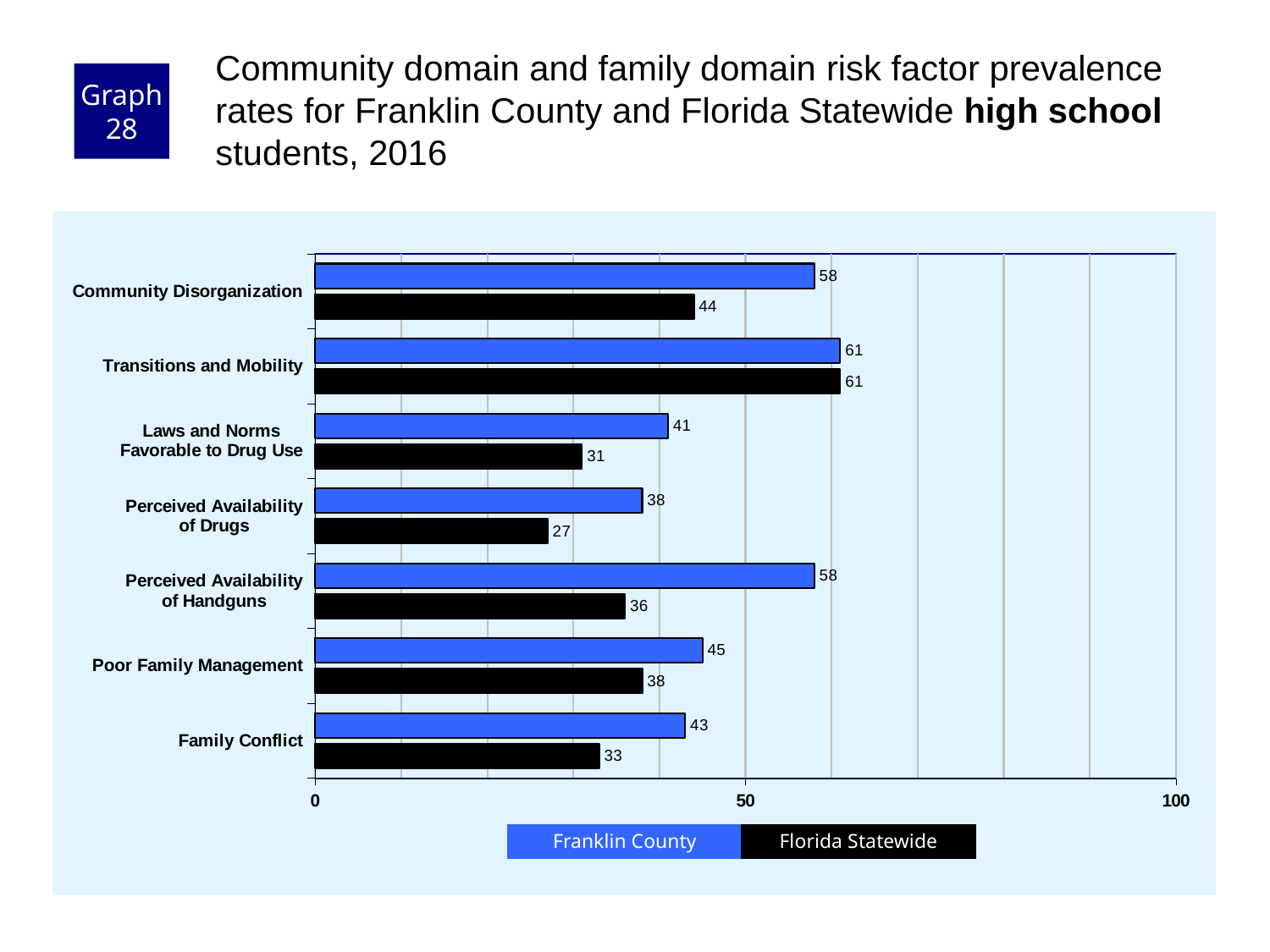
Which is larger for Family Conflict: the Franklin County value or the Florida Statewide value? Franklin County What is the Franklin County value for Poor Family Management? 45 Is the Florida Statewide value for Transitions and Mobility greater or less than 50? greater Which risk factor has the lowest Florida Statewide value? Perceived Availability of Drugs Which risk factor has the highest Franklin County value? Transitions and Mobility What is the Florida Statewide value for Perceived Availability of Drugs? 27 What is the difference between the Franklin County and Florida Statewide values for Perceived Availability of Handguns? 22 What is the Franklin County value for Community Disorganization? 58 Which colour represents Florida Statewide in the chart? black What kind of chart is shown on the slide? bar chart How many series does the legend list? 2 How many risk factor categories are shown on the chart? 7